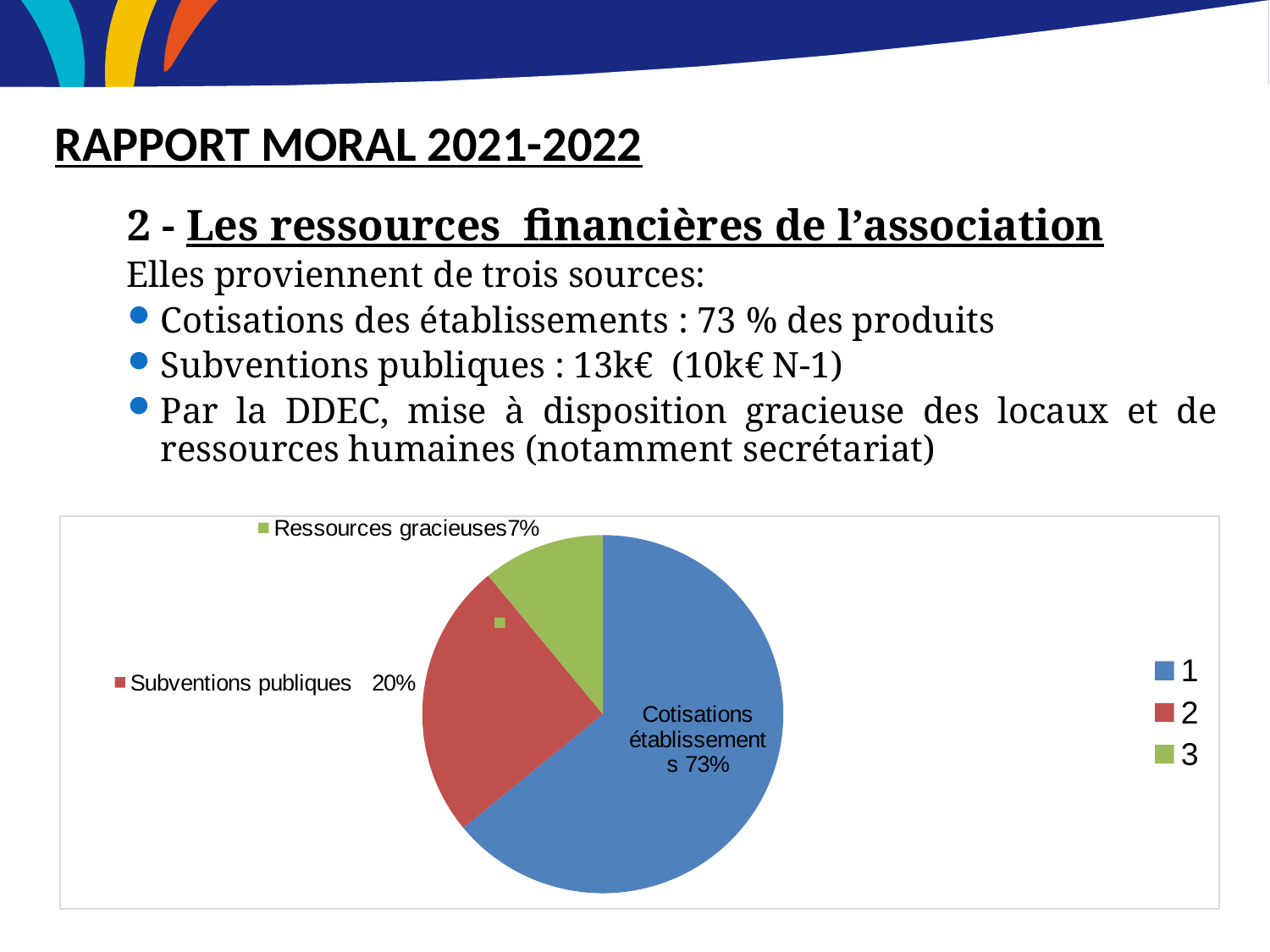
What is the difference in percentage points between Subventions publiques and Ressources gracieuses? 13 What share of the pie does Cotisations établissements represent? 73% Which is larger, the Subventions publiques slice or the Ressources gracieuses slice? Subventions publiques How many slices does the pie chart have? 3 What share of the pie does Ressources gracieuses represent? 7% How many entries does the legend of the pie chart list? 3 What is the difference in percentage points between Cotisations établissements and Subventions publiques? 53 Which slice of the pie chart is the largest? Cotisations établissements What kind of chart is shown on the slide? pie chart What colour is the Cotisations établissements slice in the pie chart? blue What share of the pie does Subventions publiques represent? 20% Which slice of the pie chart is the smallest? Ressources gracieuses